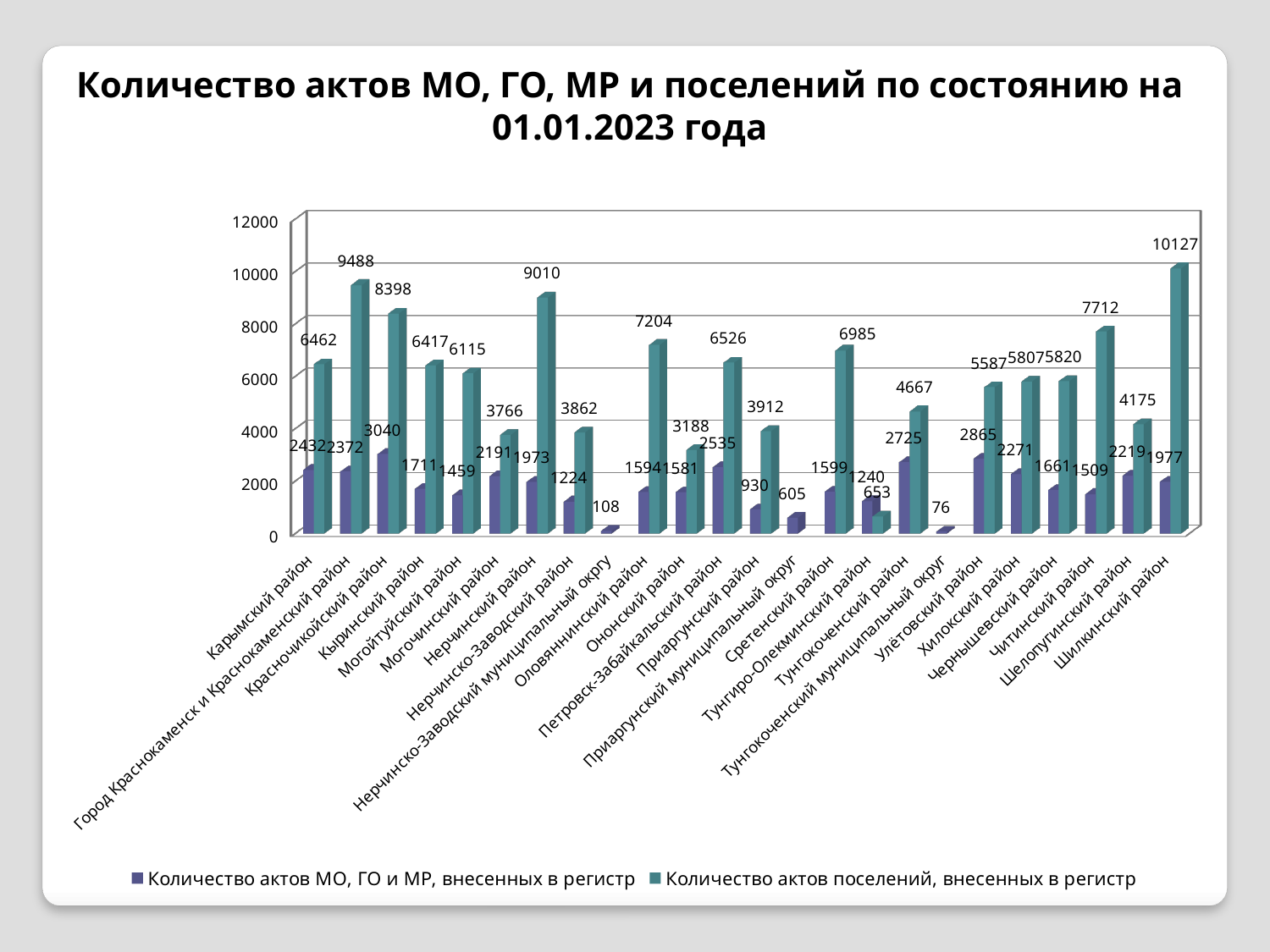
What is the value of 'Количество актов поселений, внесенных в регистр' for Шилкинский район? 10127 Which category has the highest value for 'Количество актов поселений, внесенных в регистр'? Шилкинский район What is the title of the chart? Количество актов МО, ГО, МР и поселений по состоянию на 01.01.2023 года What is the value of 'Количество актов поселений, внесенных в регистр' for Нерчинский район? 9010 What is the difference between the two series values for Шилкинский район? 8150 What type of chart is shown on the slide? bar chart How many series does the legend list? 2 Which is larger for Тунгиро-Олекминский район: 'Количество актов МО, ГО и МР, внесенных в регистр' or 'Количество актов поселений, внесенных в регистр'? Количество актов МО, ГО и МР, внесенных в регистр How many categories are shown on the x axis? 24 Which category has the lowest value for 'Количество актов МО, ГО и МР, внесенных в регистр'? Тунгокоченский муниципальный округ Is the value of 'Количество актов поселений, внесенных в регистр' for Город Краснокаменск и Краснокаменский район greater or less than 8000? greater What is the value of 'Количество актов МО, ГО и МР, внесенных в регистр' for Красночикойский район? 3040